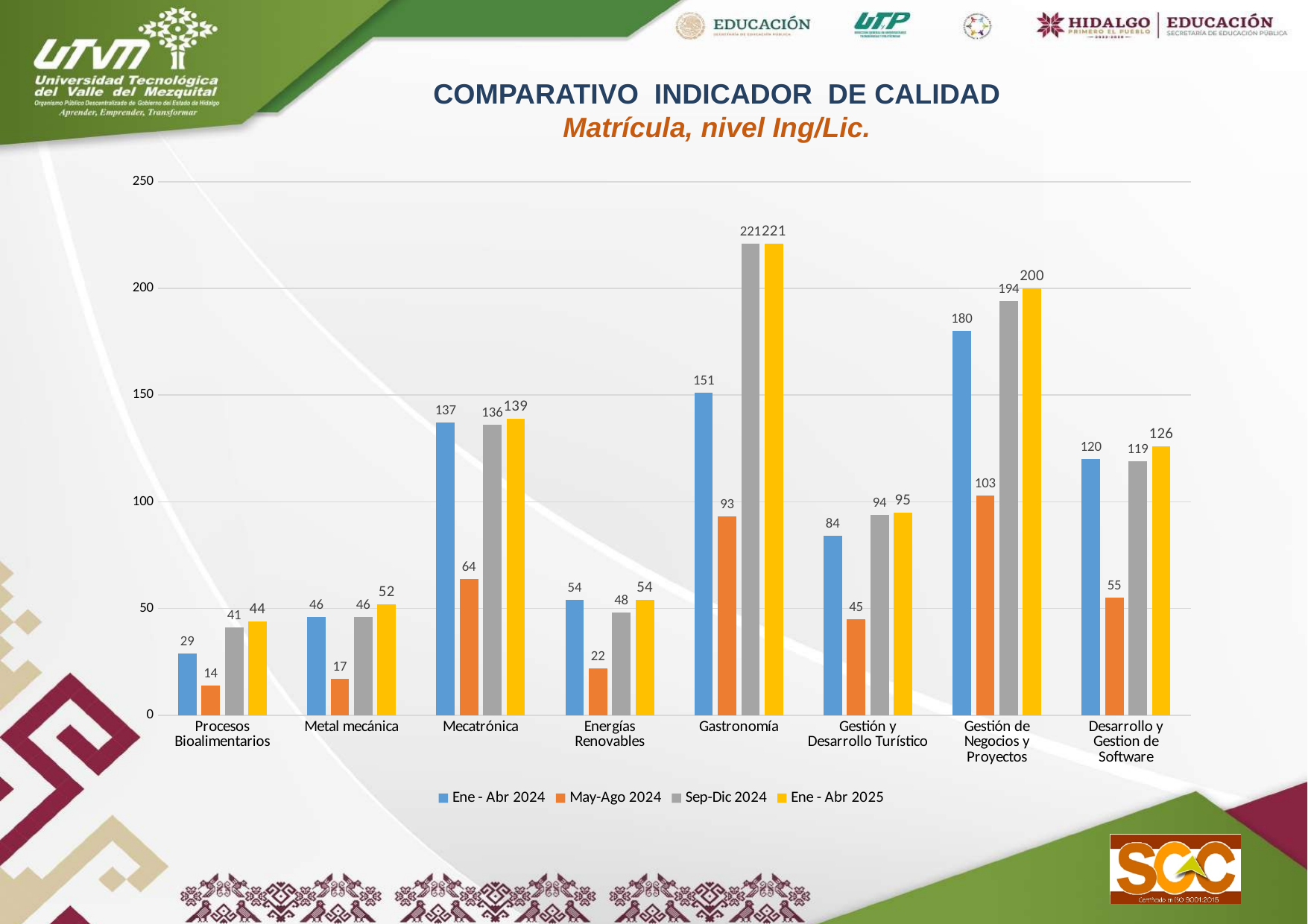
What is the Sep-Dic 2024 value for Gestión de Negocios y Proyectos? 194 What is the Ene - Abr 2025 value for Gastronomía? 221 Which program has the lowest May-Ago 2024 value? Procesos Bioalimentarios What is the difference between the Ene - Abr 2025 and Ene - Abr 2024 values for Gestión de Negocios y Proyectos? 20 How many series does the legend list? 4 Which is larger for Desarrollo y Gestion de Software: the Ene - Abr 2024 value or the Sep-Dic 2024 value? Ene - Abr 2024 What type of chart is shown on the slide? Bar chart What is the subtitle of the chart shown below 'COMPARATIVO INDICADOR DE CALIDAD'? Matrícula, nivel Ing/Lic. Which colour represents the Sep-Dic 2024 series? Gray Which program has the highest Ene - Abr 2025 value? Gastronomía How many programs (categories) are shown on the x axis? 8 What is the May-Ago 2024 value for Mecatrónica? 64